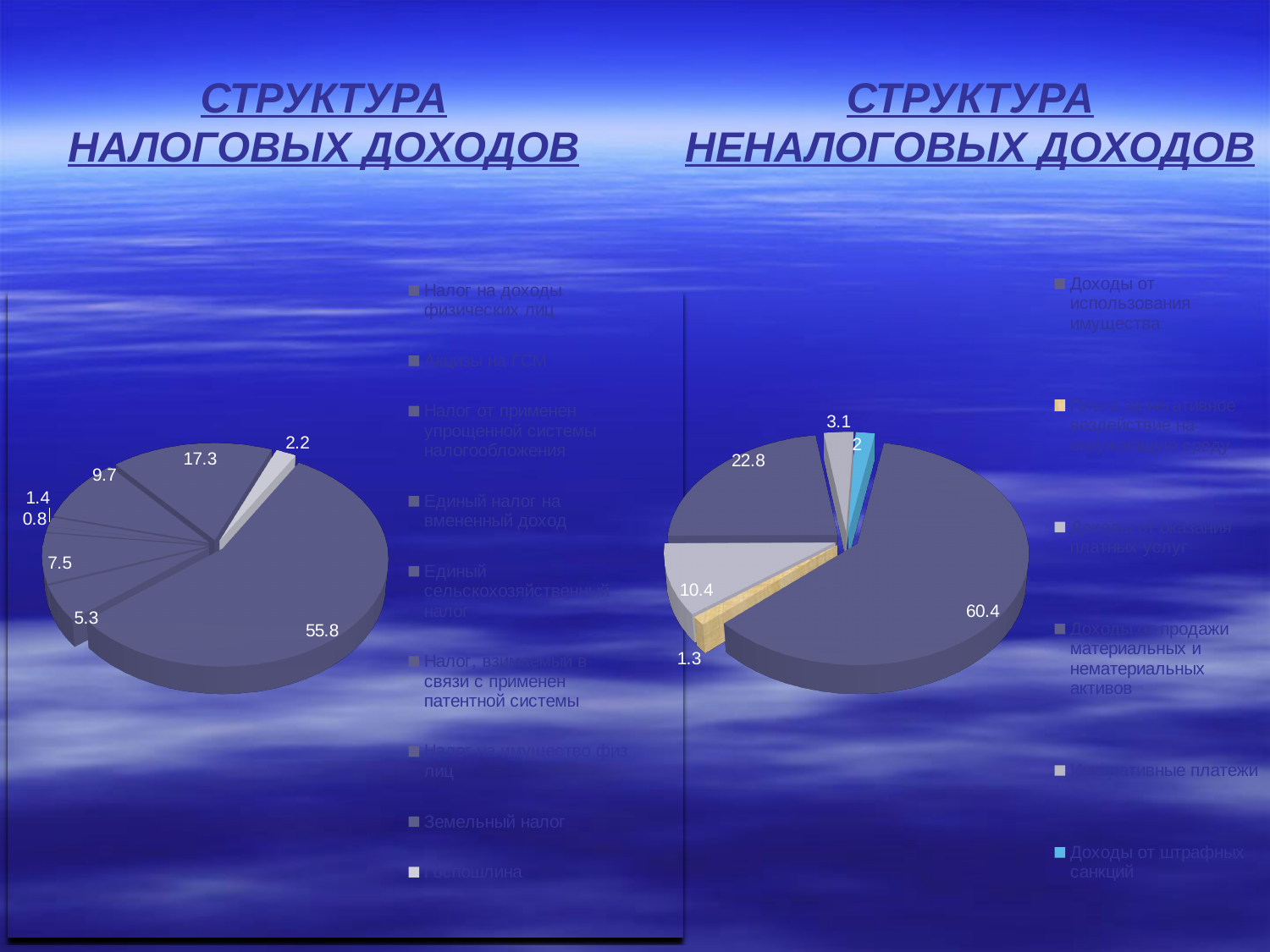
In the 'СТРУКТУРА НЕНАЛОГОВЫХ ДОХОДОВ' chart, what is the largest value labelled on the pie? 60.4 In the 'СТРУКТУРА НАЛОГОВЫХ ДОХОДОВ' chart, what is the smallest value labelled on the pie? 0.8 In the 'СТРУКТУРА НАЛОГОВЫХ ДОХОДОВ' chart, what is the largest value labelled on the pie? 55.8 What kind of chart is shown under the title 'СТРУКТУРА НАЛОГОВЫХ ДОХОДОВ'? pie chart In the 'СТРУКТУРА НАЛОГОВЫХ ДОХОДОВ' chart, what is the difference between the slice labelled 55.8 and the slice labelled 17.3? 38.5 In the 'СТРУКТУРА НЕНАЛОГОВЫХ ДОХОДОВ' chart, what is the difference between the largest slice (60.4) and the second largest slice (22.8)? 37.6 What kind of chart is shown under the title 'СТРУКТУРА НЕНАЛОГОВЫХ ДОХОДОВ'? pie chart How many entries does the legend of the 'СТРУКТУРА НЕНАЛОГОВЫХ ДОХОДОВ' chart list? 6 In the 'СТРУКТУРА НЕНАЛОГОВЫХ ДОХОДОВ' chart, which is larger: the slice labelled 10.4 or the slice labelled 3.1? 10.4 In the 'СТРУКТУРА НЕНАЛОГОВЫХ ДОХОДОВ' chart, what is the smallest value labelled on the pie? 1.3 How many entries does the legend of the 'СТРУКТУРА НАЛОГОВЫХ ДОХОДОВ' chart list? 9 In the 'СТРУКТУРА НЕНАЛОГОВЫХ ДОХОДОВ' chart, what value is labelled on the light blue slice for 'Доходы от штрафных санкций'? 2